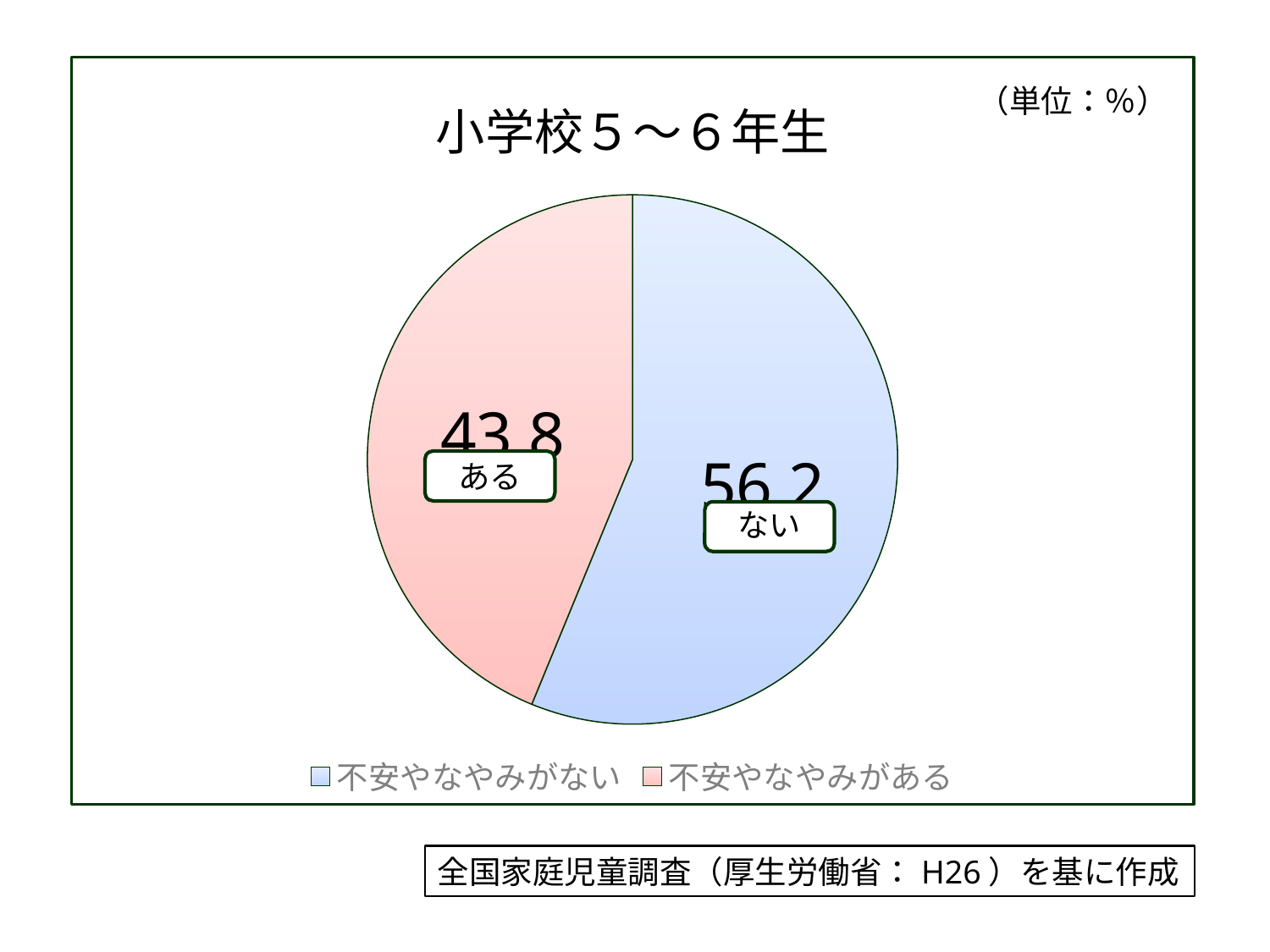
Which is larger, the value for 不安やなやみがある or the value for 不安やなやみがない? 不安やなやみがない How many slices does the pie chart have? 2 How many entries does the legend list? 2 What is the difference between the values for 不安やなやみがない and 不安やなやみがある? 12.4 What is the value for 不安やなやみがある? 43.8 Which category has the smallest slice of the pie? 不安やなやみがある Which category has the largest slice of the pie? 不安やなやみがない What unit is indicated for the chart values? % What is the value for 不安やなやみがない? 56.2 What kind of chart is shown on the slide? pie chart What is the title of the chart? 小学校５～６年生 What share of the pie does the 不安やなやみがある slice represent? 43.8%